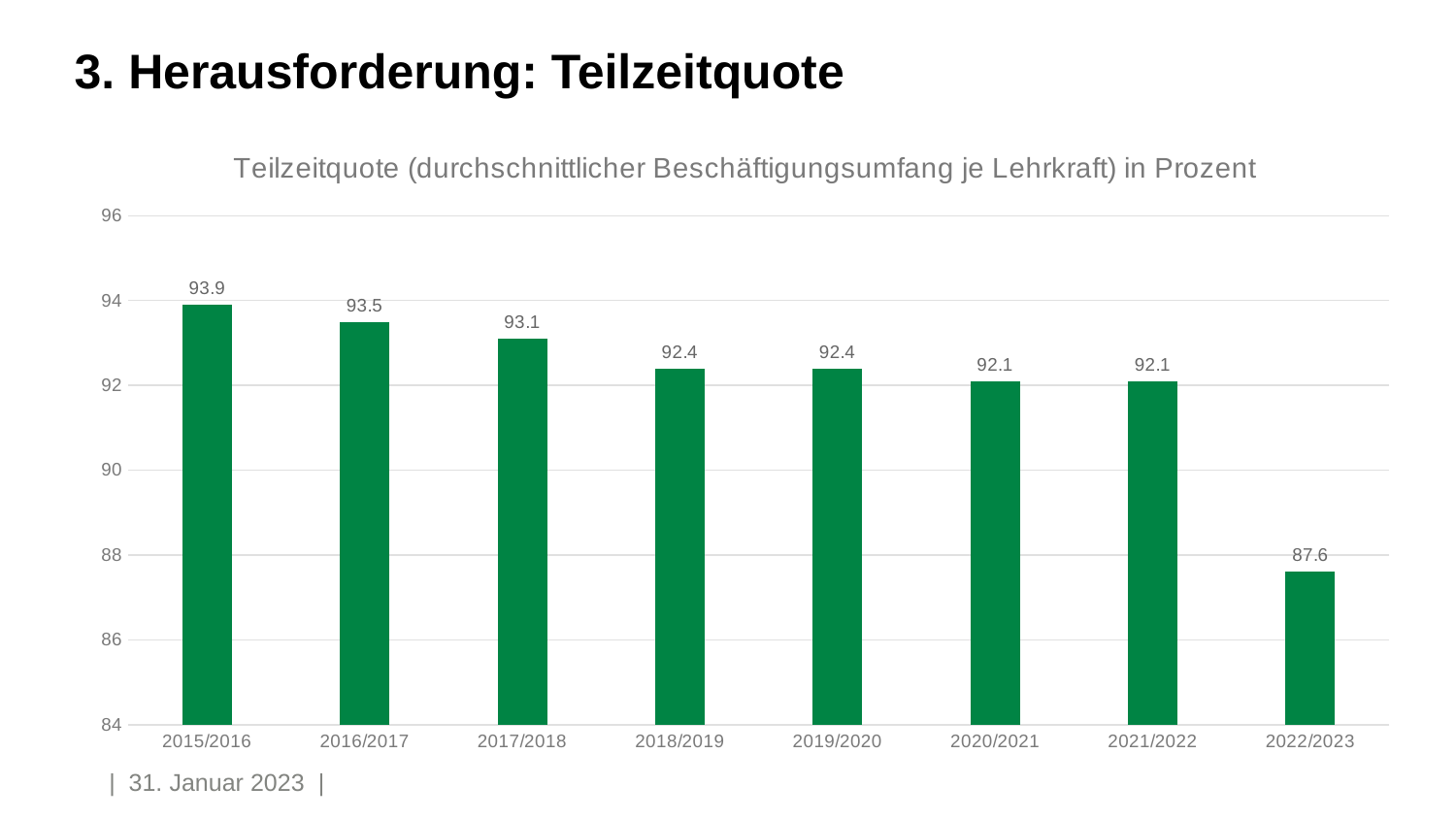
What is the value for 2022/2023? 87.6 What is the difference between the values for 2016/2017 and 2017/2018? 0.4 Which is larger, the value for 2018/2019 or the value for 2021/2022? 2018/2019 Do the values rise or fall from 2015/2016 to 2022/2023? fall What is the value for 2017/2018? 93.1 How many school years are shown on the x axis? 8 Which school year has the highest value? 2015/2016 Is the value for 2022/2023 greater or less than 88? less What is the value for 2015/2016? 93.9 What kind of chart is shown on the slide? bar chart Which school year has the lowest value? 2022/2023 What is the difference between the values for 2015/2016 and 2022/2023? 6.3